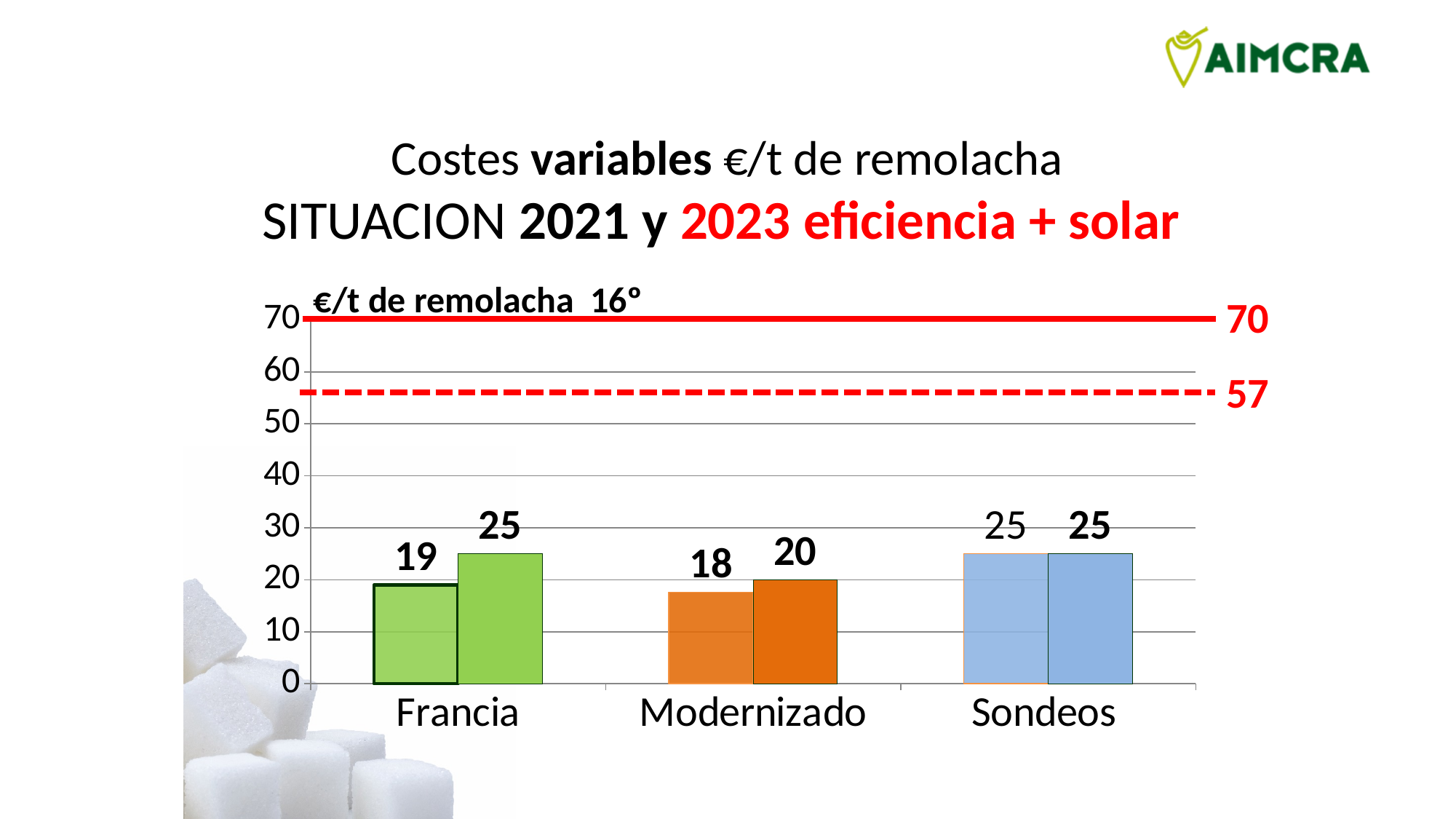
What value is shown for both bars of Sondeos? 25 What kind of chart is shown on the slide? Bar chart Which category has the lowest value among the left bars? Modernizado What is the difference between the right bar and the left bar for Modernizado? 2 What value is marked by the solid red horizontal line at the top of the chart? 70 What is the value of the left bar for Modernizado? 18 Which is larger: the right bar for Francia or the right bar for Modernizado? Francia What is the value of the right bar for Modernizado? 20 What is the value of the left bar for Francia? 19 How many categories are shown on the x axis? 3 What is the difference between the right bar and the left bar for Francia? 6 What is the value of the right bar for Francia? 25